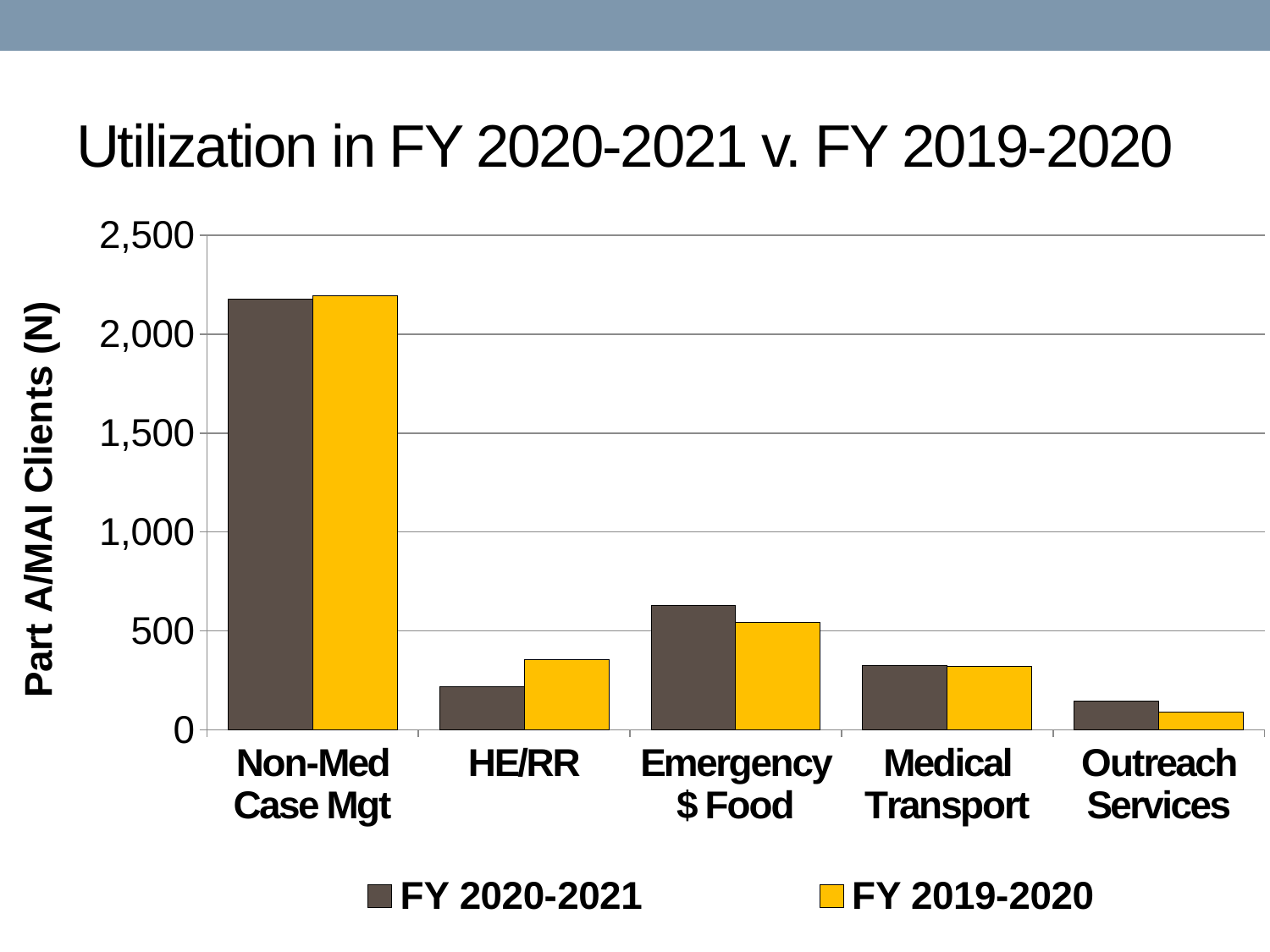
What is the title of the vertical axis? Part A/MAI Clients (N) Which category has the lowest value for FY 2019-2020? Outreach Services For Outreach Services, which fiscal year has the larger value? FY 2020-2021 Is the FY 2020-2021 value for Emergency $ Food greater or less than 500? greater How many series does the legend list? 2 Is the FY 2020-2021 value for HE/RR greater or less than 500? less How many service categories are shown on the x axis? 5 What kind of chart is shown on the slide? bar chart Is the FY 2020-2021 value for Non-Med Case Mgt greater or less than 2,000? greater Which category has the highest value for FY 2020-2021? Non-Med Case Mgt For HE/RR, which fiscal year has the larger value? FY 2019-2020 For Emergency $ Food, which fiscal year has the larger value? FY 2020-2021